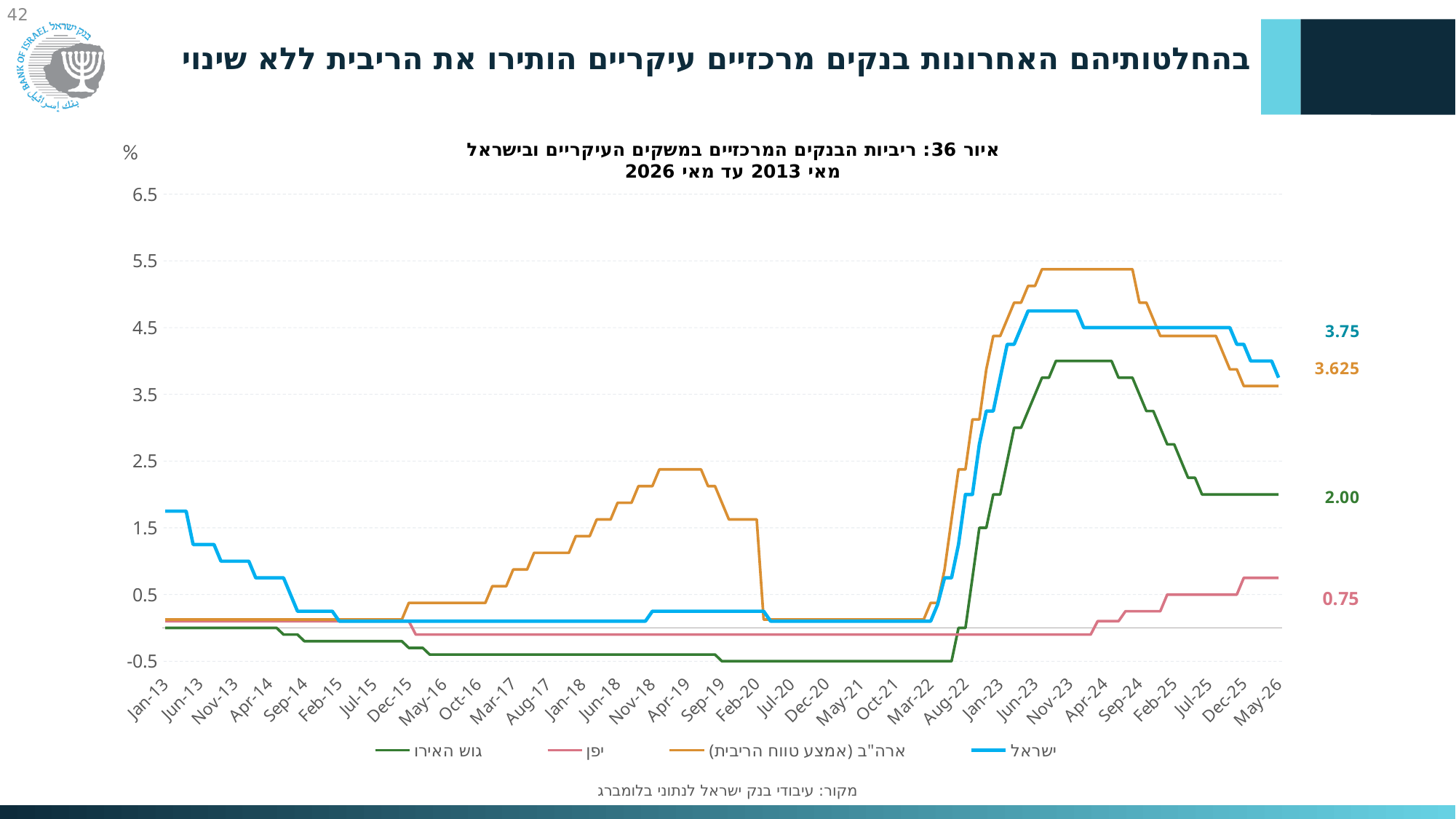
Does the ארה"ב series rise or fall between Mar-22 and Jun-23? Rise Is the peak value of the ארה"ב series around Nov-23 greater or less than 4.5? greater What is the latest value shown for ארה"ב (אמצע טווח הריבית) at the right end of the chart? 3.625 Which series has the highest value at the right end of the chart? ישראל At the right end of the chart, which is larger: the value for גוש האירו or the value for יפן? גוש האירו What is the latest value shown for ישראל (Israel) at the right end of the chart? 3.75 What is the latest value shown for גוש האירו (euro area) at the right end of the chart? 2.00 Which series has the lowest value at the right end of the chart? יפן What is the latest value shown for יפן (Japan) at the right end of the chart? 0.75 What kind of chart is shown on the slide? Line chart How many series does the legend list? 4 What is the difference between the latest values of ישראל (3.75) and ארה"ב (3.625)? 0.125